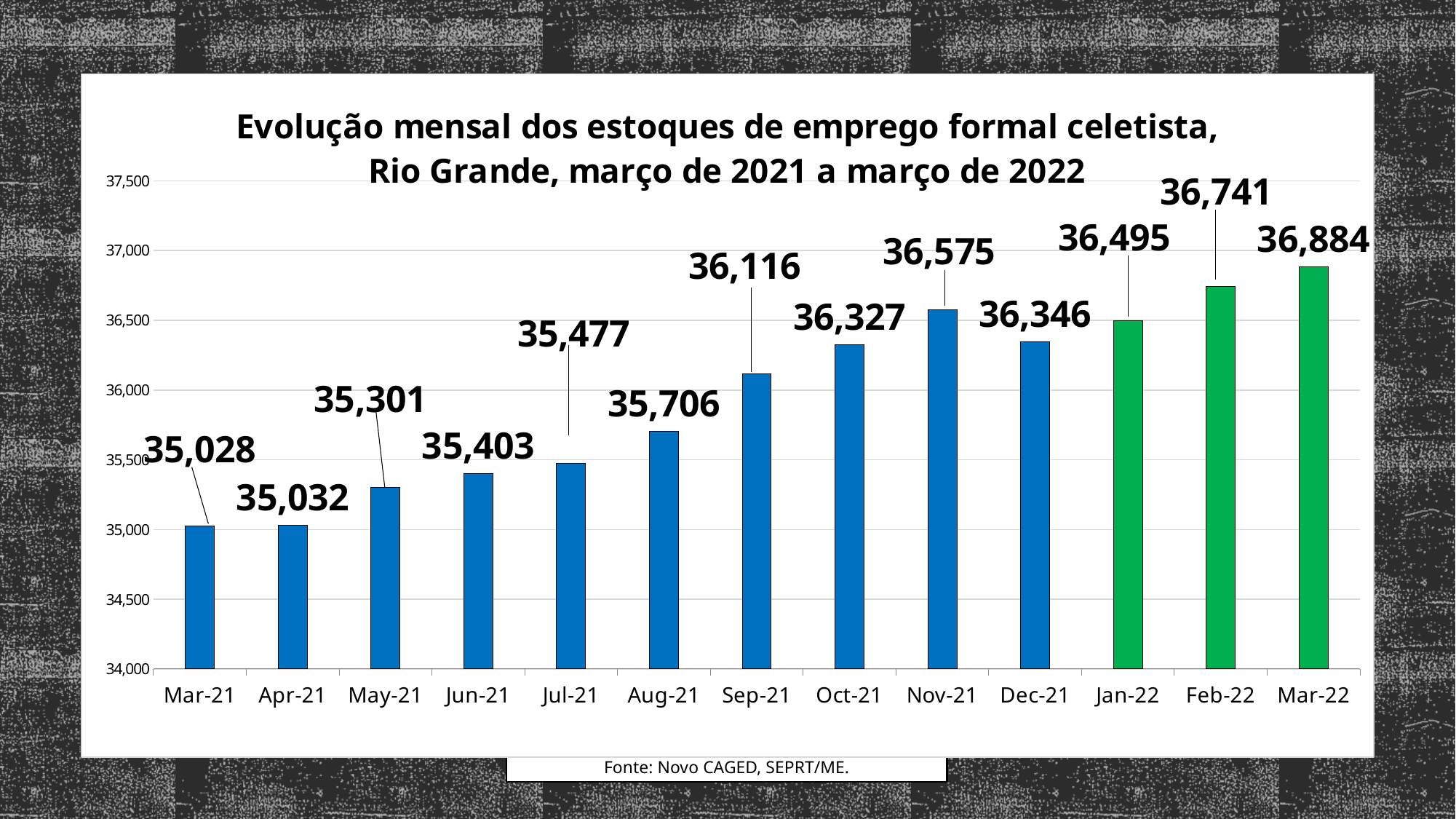
What is the value for Jul-21? 35,477 Which is larger, the value for Nov-21 or the value for Jan-22? Nov-21 What is the difference between the values for Mar-22 and Mar-21? 1,856 Which months are shown with green bars? Jan-22, Feb-22, Mar-22 What is the value for Sep-21? 36,116 How many months are shown on the x axis? 13 What is the value for Jan-22? 36,495 Which month has the highest value? Mar-22 What is the difference between the values for Nov-21 and Dec-21? 229 What kind of chart is shown on the slide? bar chart Which month has the lowest value? Mar-21 Is the value for Aug-21 greater or less than 36,000? less